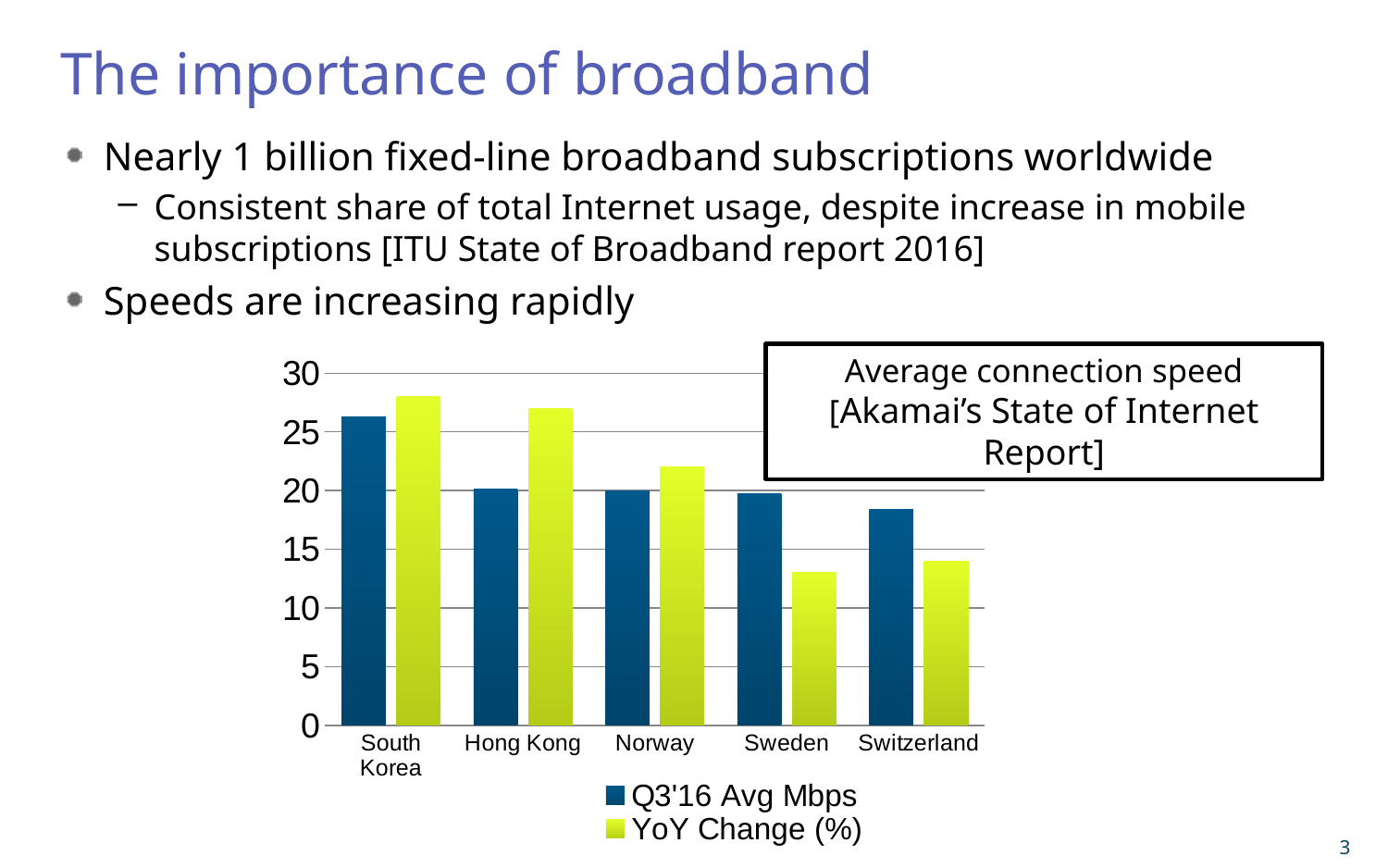
Which country has the lowest Q3'16 Avg Mbps value? Switzerland Do the Q3'16 Avg Mbps values rise or fall from South Korea to Switzerland along the x axis? fall How many series does the chart's legend list? 2 Which country has the highest Q3'16 Avg Mbps value? South Korea Is the YoY Change (%) value for Hong Kong greater or less than 25? greater Is the Q3'16 Avg Mbps value for South Korea greater or less than 25? greater Is the Q3'16 Avg Mbps value for Switzerland greater or less than 20? less What is the title shown in the box on the chart? Average connection speed [Akamai's State of Internet Report] How many countries are shown on the x axis of the chart? 5 What kind of chart is shown on the slide? bar chart Which is larger: the YoY Change (%) for South Korea or for Sweden? South Korea